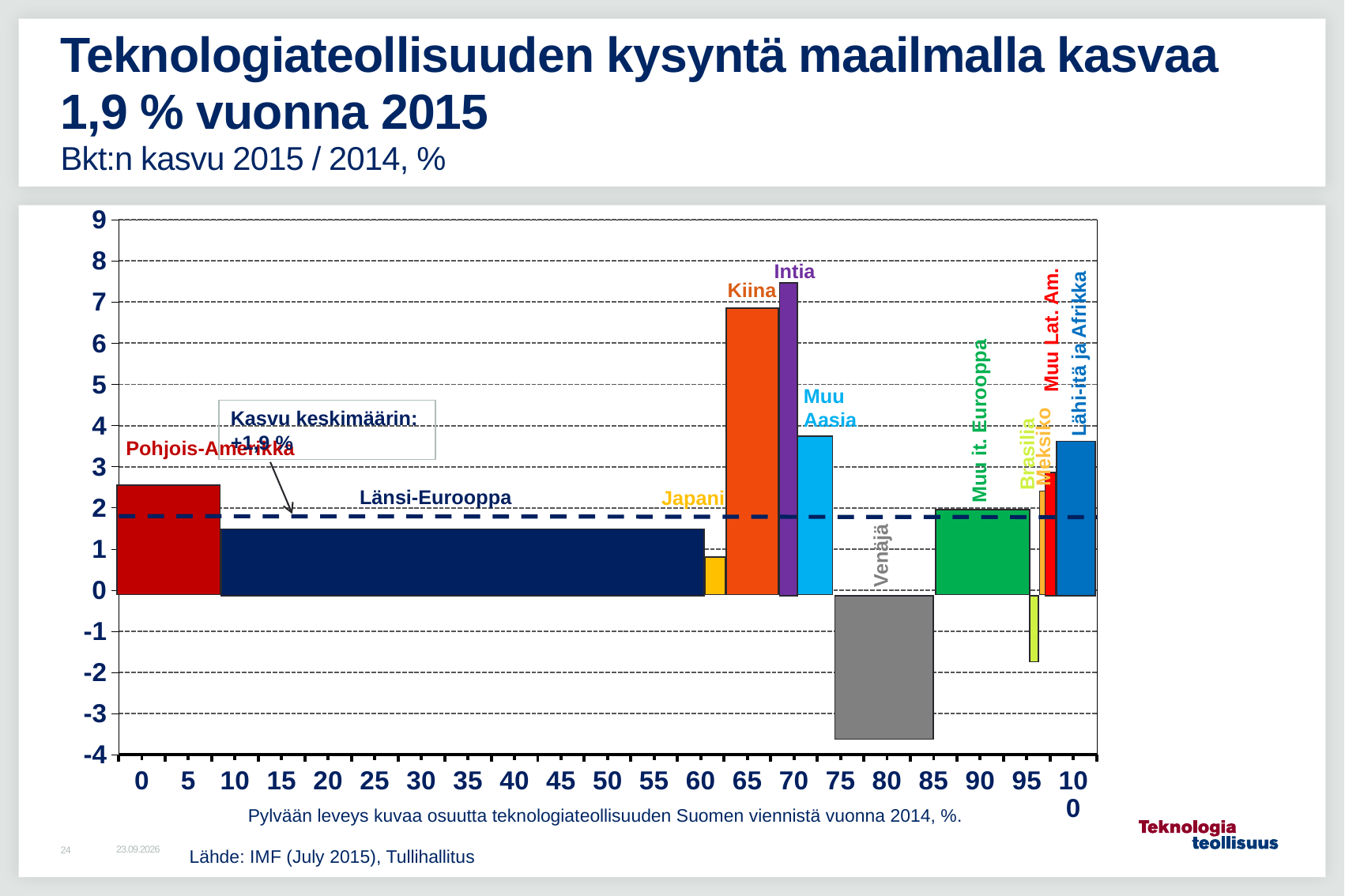
Which region has the lowest GDP growth in the chart? Venäjä Which has the larger GDP growth, Kiina or Muu Aasia? Kiina Is the value for Kiina greater or less than 6? greater Which region has the highest GDP growth in the chart? Intia Is the value for Venäjä greater or less than -3? less What average growth value is shown in the text box on the chart? +1,9 % According to the note below the chart, what does the width of each bar represent? Share of Finland's technology industry exports in 2014, % What kind of chart is shown on the slide? bar chart Is the value for Länsi-Eurooppa greater or less than 2? less How many regions (bars) are shown in the chart? 12